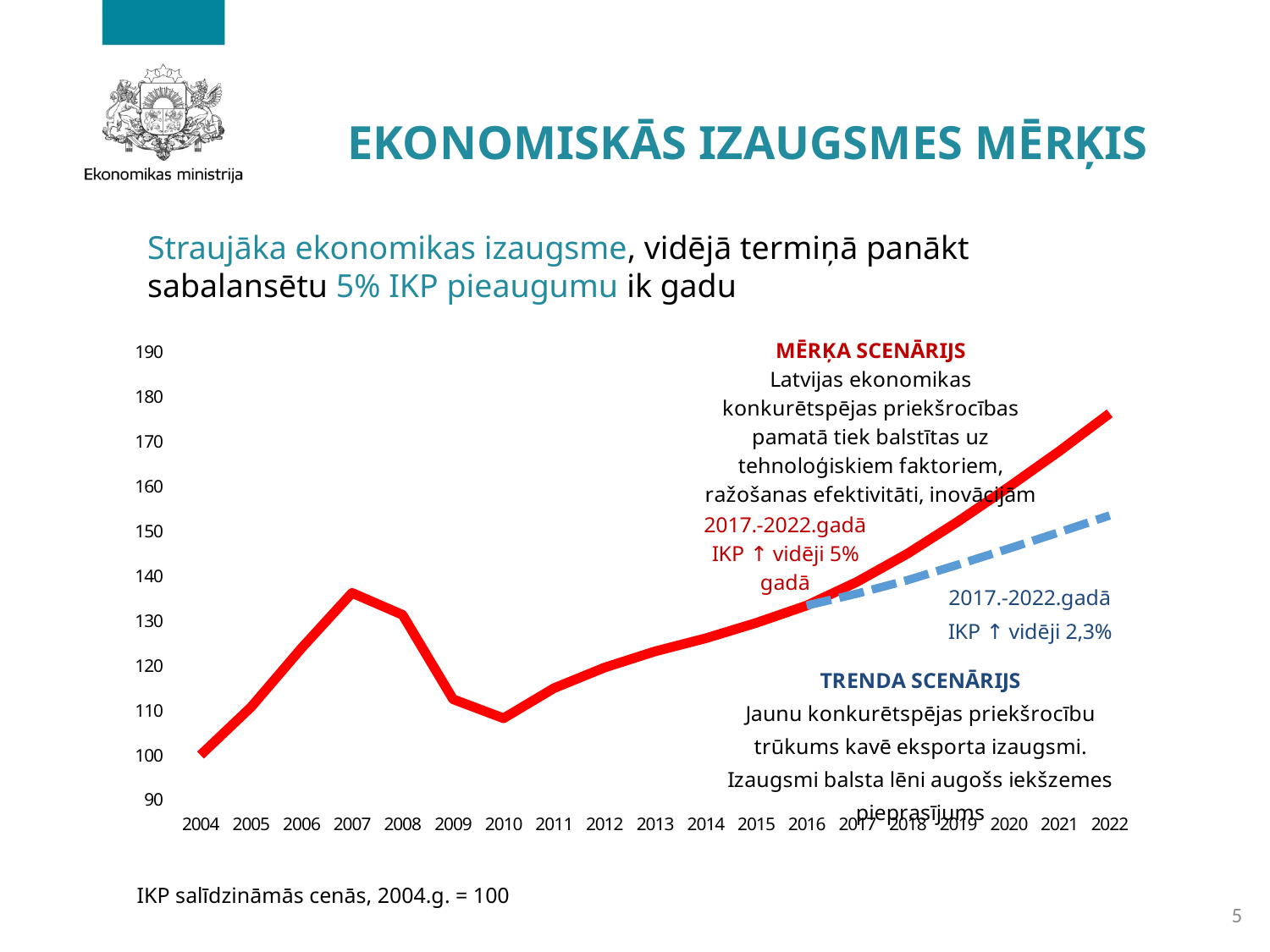
Which year has the lowest value on the chart? 2004 How many years are shown on the x axis of the chart? 19 In 2022, which line is higher: the red solid line (Mērķa scenārijs) or the blue dashed line (Trenda scenārijs)? the red solid line (Mērķa scenārijs) Is the value for 2010 greater or less than 120? less Do the values rise or fall between 2010 and 2016? rise What is the index value for 2004 on the chart? 100 According to the chart annotation, what is the average annual GDP growth in 2017-2022 under the Trenda scenārijs? 2,3% Is the value for 2007 greater or less than 130? greater What kind of chart is shown on the slide? line chart Is the value of the blue dashed line (Trenda scenārijs) for 2022 greater or less than 160? less Do the values rise or fall between 2007 and 2009? fall